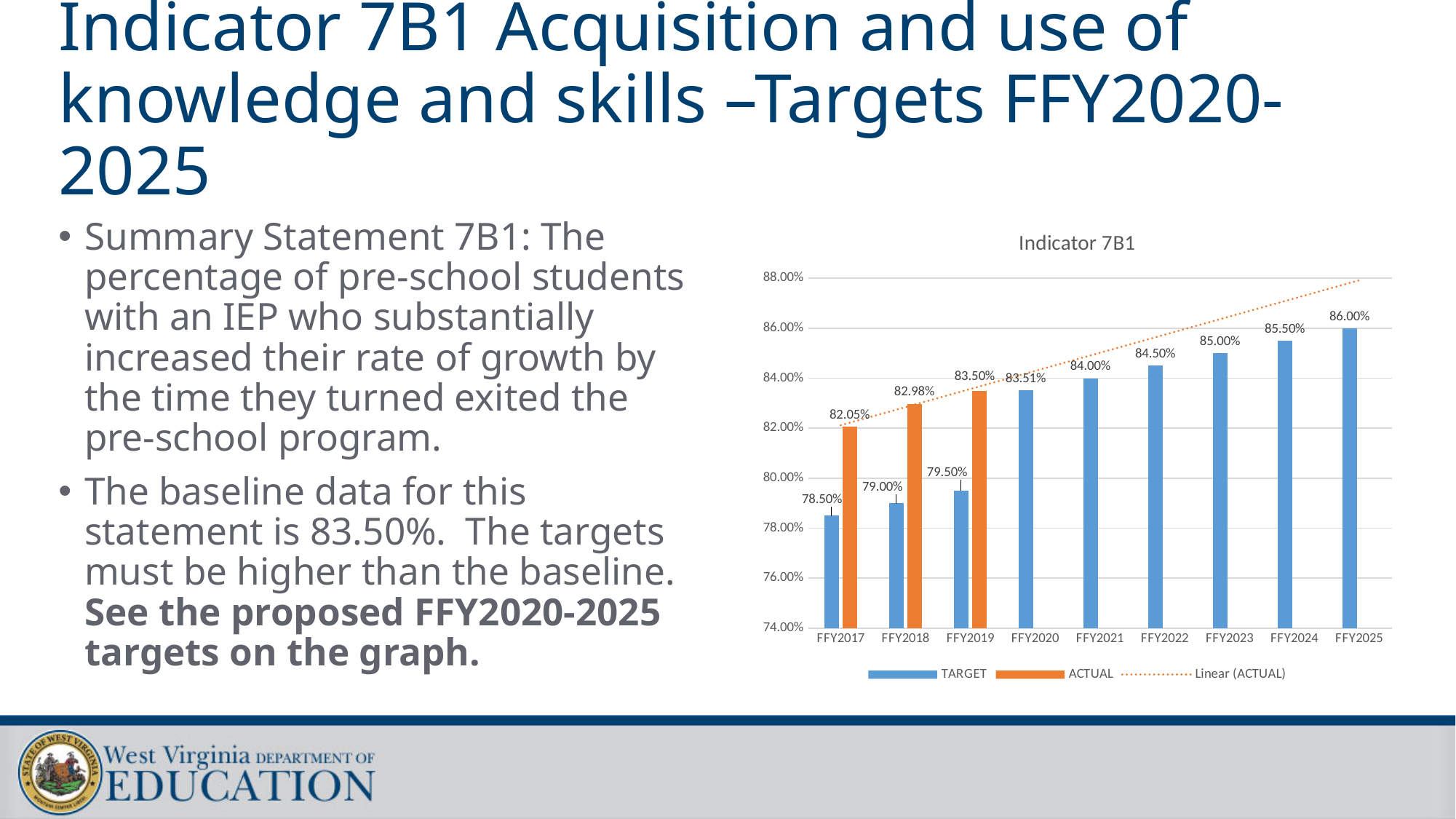
Which year has the lowest TARGET value? FFY2017 How many years are shown on the x axis? 9 What is the difference between the ACTUAL and TARGET values for FFY2017? 3.55% What is the TARGET value for FFY2025? 86.00% What is the ACTUAL value for FFY2019? 83.50% What kind of chart is shown? Bar chart Do the TARGET values rise or fall from FFY2020 to FFY2025? Rise What is the ACTUAL value for FFY2018? 82.98% Which is larger for FFY2019, the TARGET value or the ACTUAL value? ACTUAL What is the TARGET value for FFY2017? 78.50% How many entries does the legend list? 3 Which year has the highest TARGET value? FFY2025